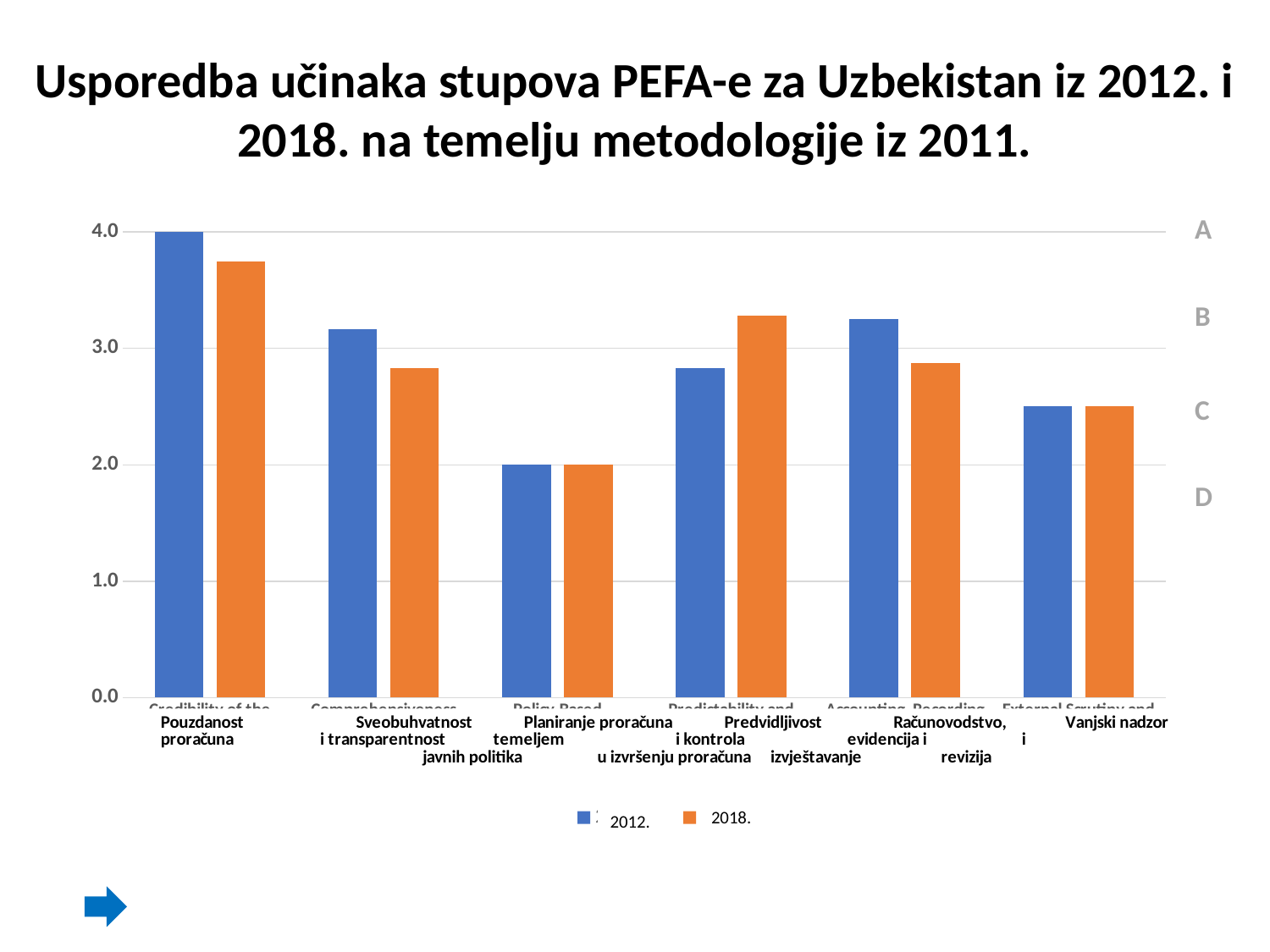
Is the 2012. value for Računovodstvo, evidencija i izvještavanje greater or less than 3.0? greater What is the difference between the 2012. value for Pouzdanost proračuna and the 2012. value for Planiranje proračuna temeljem javnih politika? 2.0 What kind of chart is shown on the slide? bar chart What is the 2012. value for Planiranje proračuna temeljem javnih politika? 2.0 Which category has the lowest 2018. value? Planiranje proračuna temeljem javnih politika Which category has the highest 2012. value? Pouzdanost proračuna What is the 2018. value for Planiranje proračuna temeljem javnih politika? 2.0 Is the 2018. value for Sveobuhvatnost i transparentnost greater or less than 3.0? less For Predvidljivost i kontrola u izvršenju proračuna, which is larger: the 2012. value or the 2018. value? 2018. How many series does the legend list? 2 How many categories (PEFA pillars) are shown on the x axis? 6 What is the 2012. value for Pouzdanost proračuna? 4.0